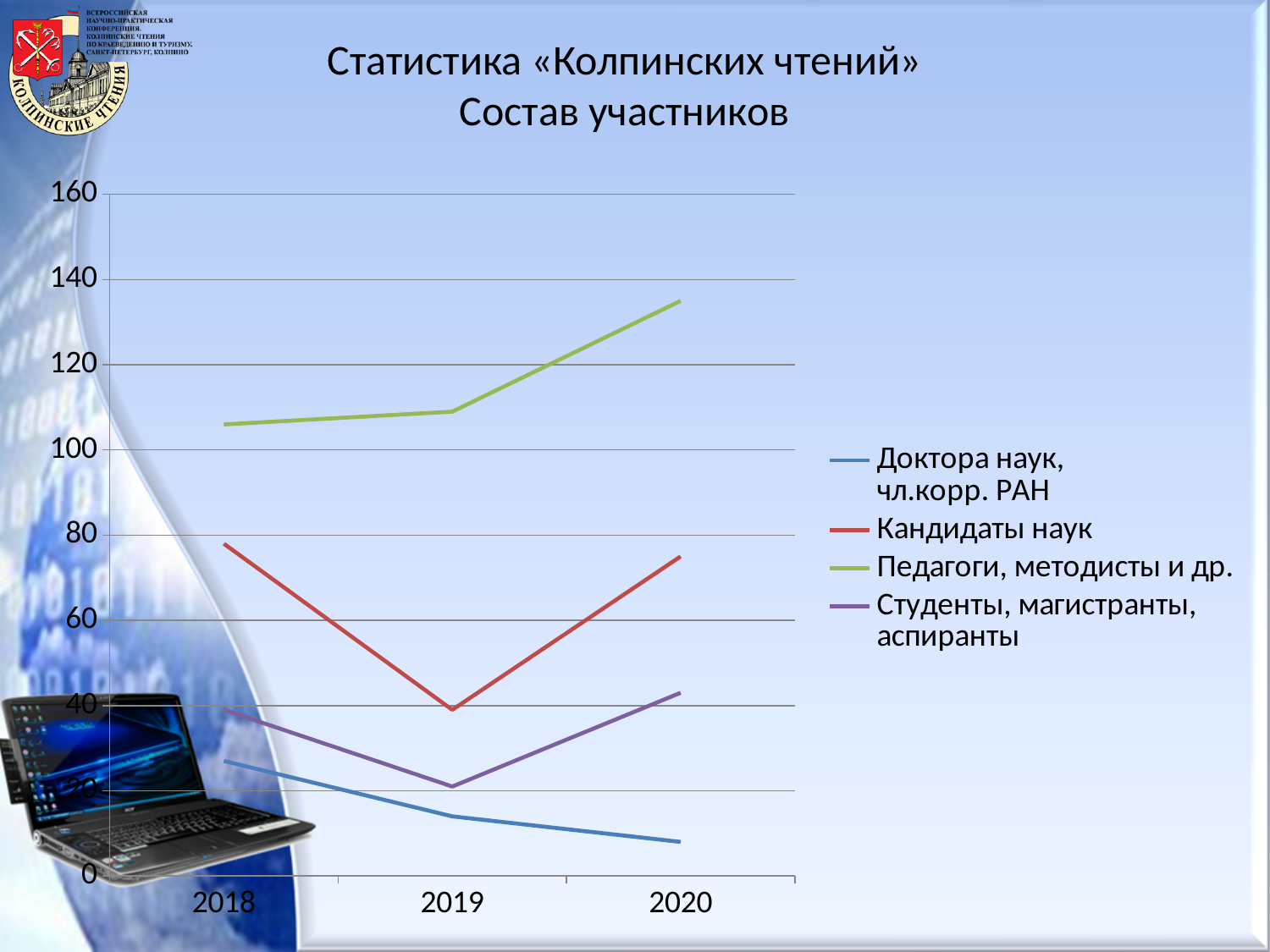
Which series has the lowest value in 2019? Доктора наук, чл.корр. РАН Which series has the highest value in 2020? Педагоги, методисты и др. Is the value for Доктора наук, чл.корр. РАН in 2020 greater or less than 20? less How many series does the legend list? 4 What is the second line of the chart title? Состав участников Does the value for Педагоги, методисты и др. rise or fall from 2018 to 2020? rise What kind of chart is shown on the slide? line chart Is the value for Педагоги, методисты и др. in 2020 greater or less than 120? greater Does the value for Доктора наук, чл.корр. РАН rise or fall from 2018 to 2020? fall How many years are shown on the x axis? 3 Is the value for Кандидаты наук in 2020 greater or less than 60? greater For Кандидаты наук, which year has the larger value, 2018 or 2019? 2018